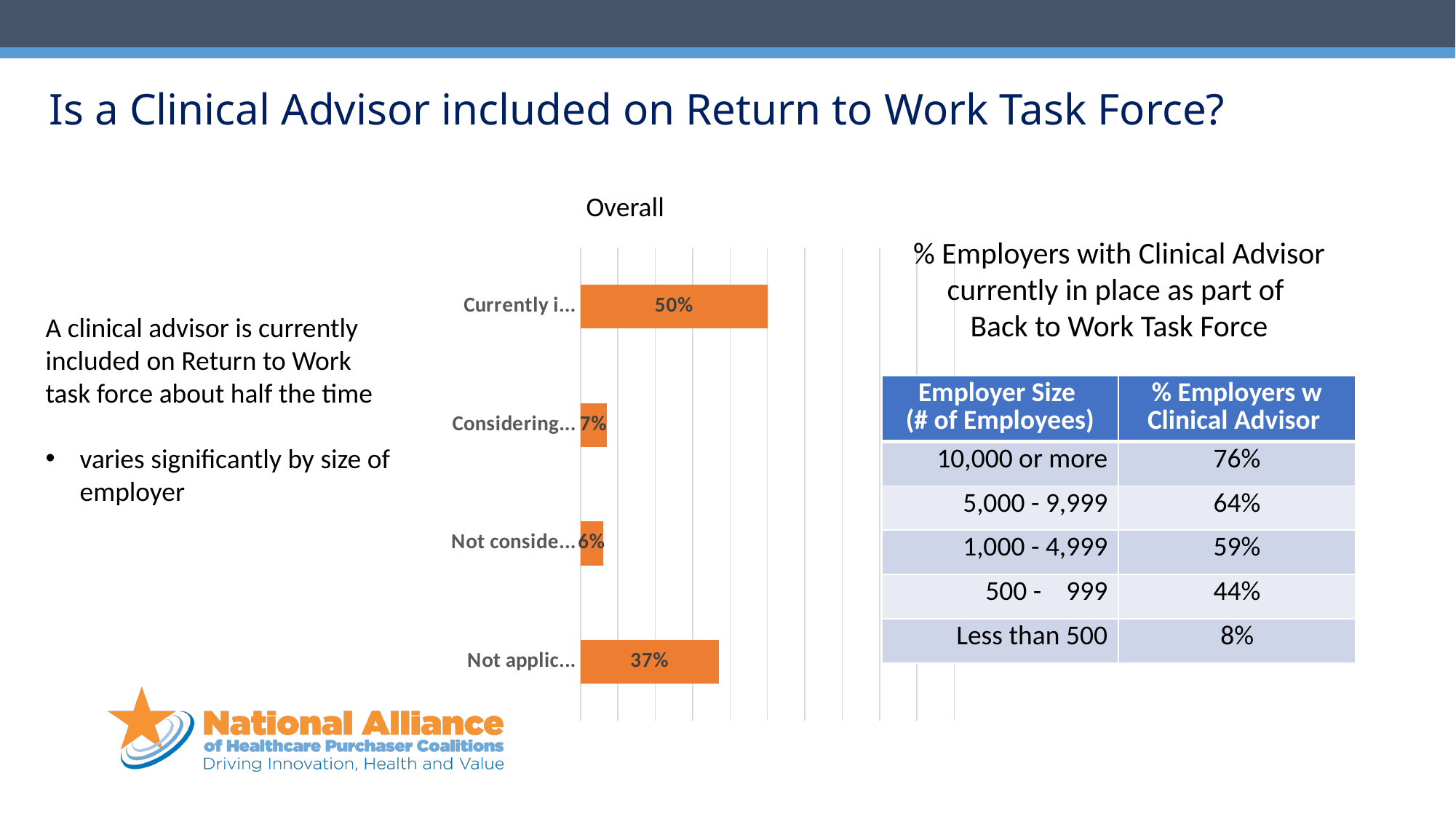
In the 'Overall' chart, which category has the lowest value? Not conside... In the 'Overall' chart, what is the value of the bar labelled 'Considering...'? 7% What kind of chart is the 'Overall' chart on the slide? bar chart In the 'Overall' chart, which category has the highest value? Currently i... In the 'Overall' chart, what is the value of the top bar labelled 'Currently i...'? 50% In the 'Overall' chart, what is the difference between the 'Currently i...' bar and the 'Not applic...' bar? 13% In the 'Overall' chart, what is the value of the bar labelled 'Not conside...'? 6% What colour are the bars in the 'Overall' chart? orange How many bars are shown in the 'Overall' chart? 4 In the 'Overall' chart, which is larger: the 'Not applic...' bar or the 'Considering...' bar? Not applic... In the 'Overall' chart, what is the value of the bottom bar labelled 'Not applic...'? 37% In the 'Overall' chart, what is the difference between the 'Considering...' bar and the 'Not conside...' bar? 1%